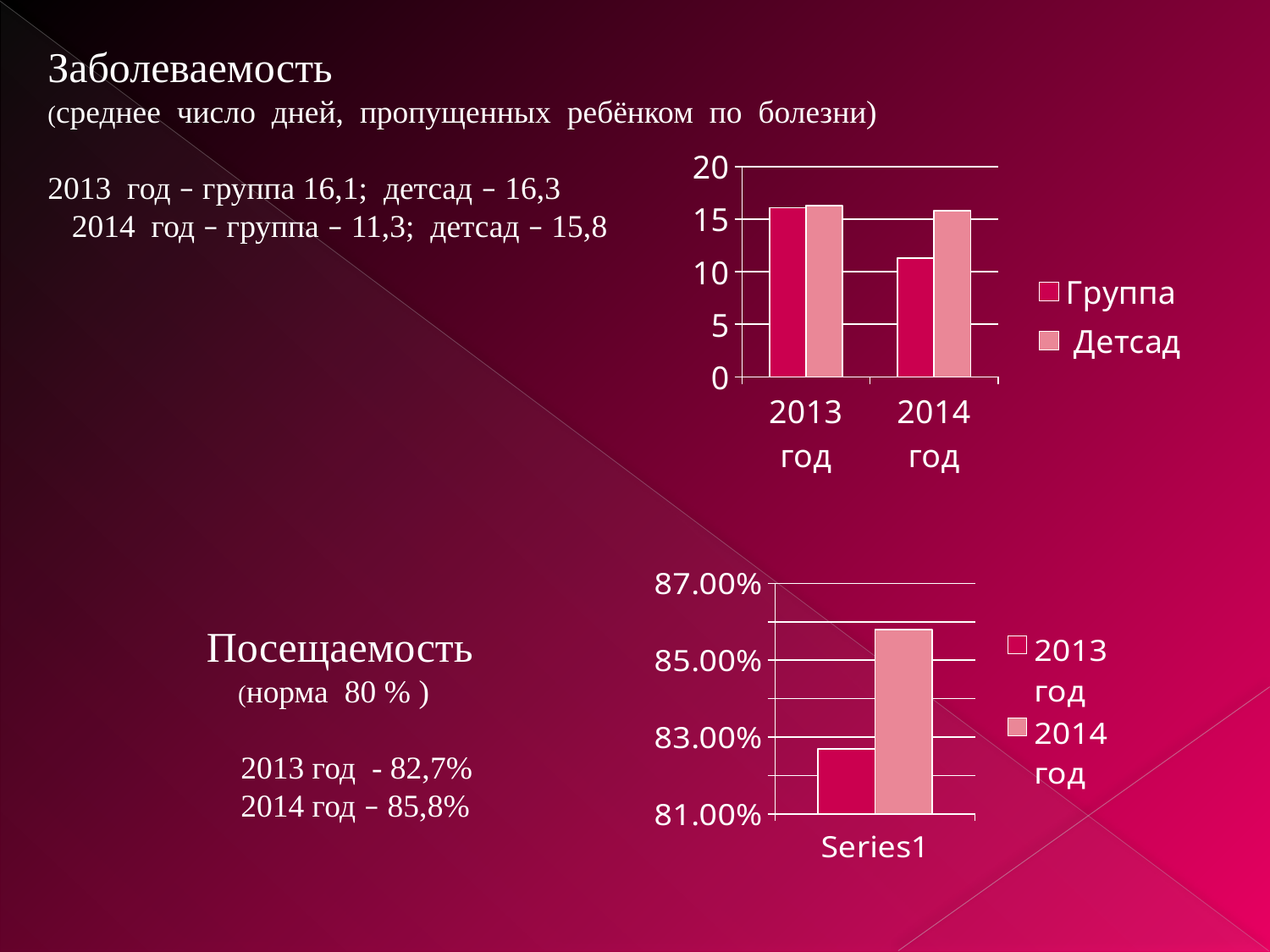
In the top chart, does the value for Группа rise or fall from 2013 год to 2014 год? fall In the top chart, how many categories are shown on the x axis? 2 In the bottom chart, which series has the higher value, 2013 год or 2014 год? 2014 год In the top chart, is the value for Группа in 2014 год greater or less than 15? less In the top chart, what is the value for Группа in 2013 год? 16,1 In the top chart, what is the value for Детсад in 2014 год? 15,8 In the top chart, which is larger in 2014 год, Группа or Детсад? Детсад In the top chart, what type of chart is shown? bar chart In the bottom chart, how many series does the legend list? 2 In the bottom chart, is the value for 2014 год greater or less than 85.00%? greater In the top chart, how many series does the legend list? 2 In the top chart, what is the difference between Детсад and Группа in 2014 год? 4,5